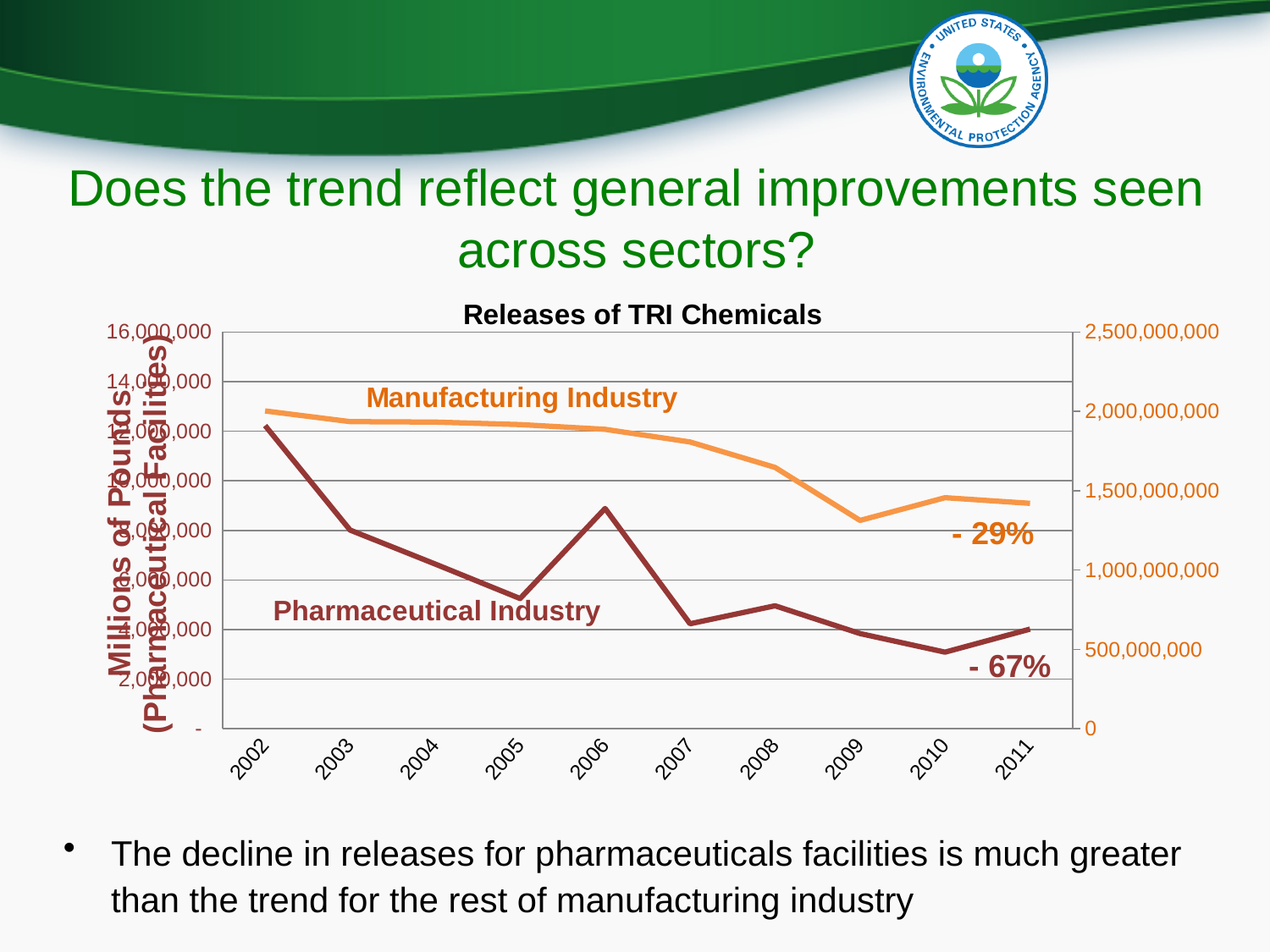
Is the Manufacturing Industry value for 2009 greater or less than 1,500,000,000? less Is the Pharmaceutical Industry value for 2003 greater or less than 10,000,000? less Which year has the larger Pharmaceutical Industry value, 2005 or 2006? 2006 How many series are plotted in the chart? 2 Is the Pharmaceutical Industry value for 2006 greater or less than 8,000,000? greater In which year is the Pharmaceutical Industry line at its highest? 2002 What kind of chart is shown on the slide? line chart How many years are shown along the x axis of the chart? 10 What is the title of the chart? Releases of TRI Chemicals In which year is the Manufacturing Industry line at its lowest? 2009 What percentage change is labelled on the chart for the Manufacturing Industry line? - 29% In which year is the Pharmaceutical Industry line at its lowest? 2010